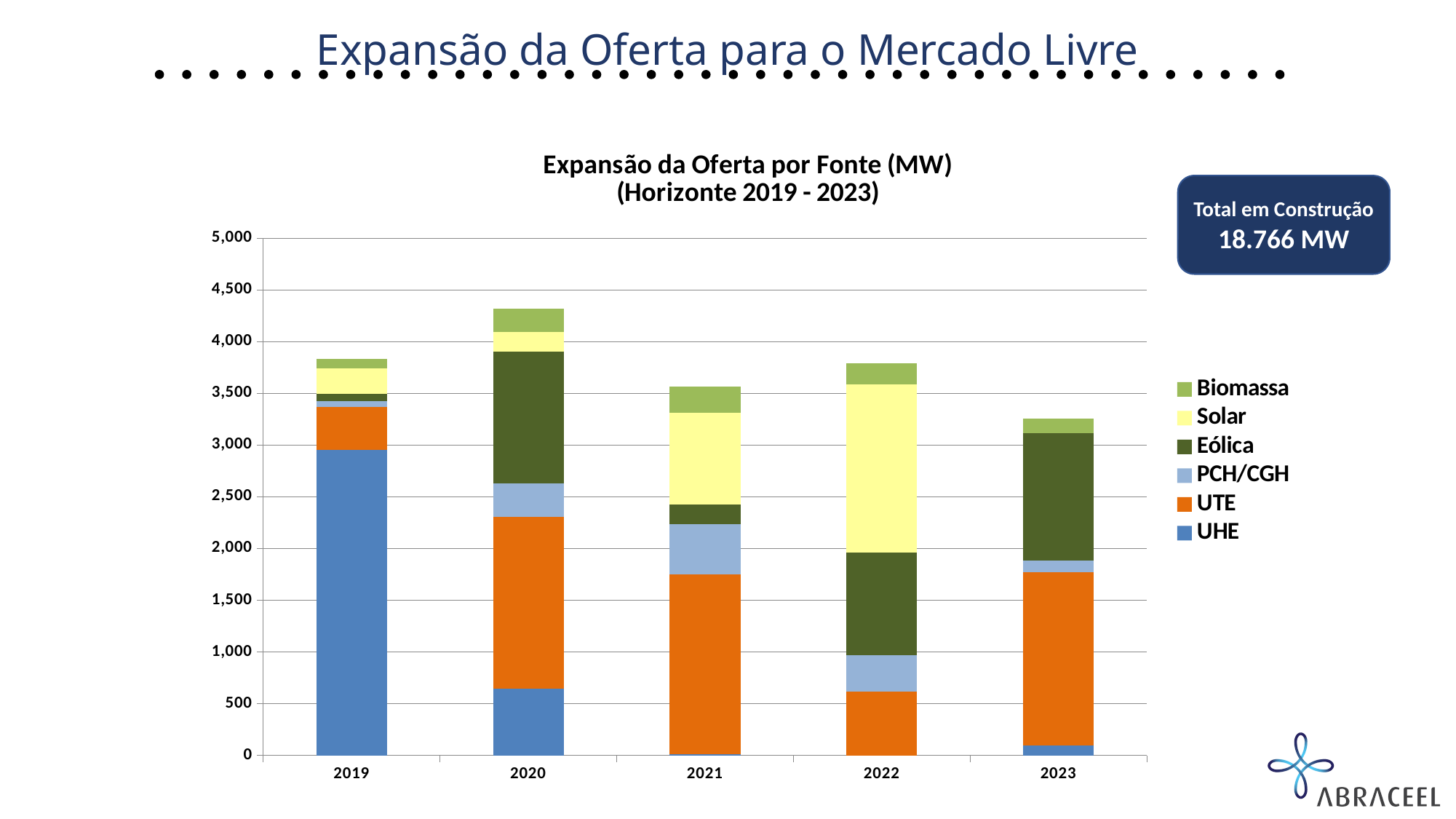
Is the UHE segment for 2019 greater or less than 2,500? greater Which year has the highest total stacked bar? 2020 Is the total stacked bar for 2023 greater or less than 3,500? less Which total stacked bar is taller, 2019 or 2021? 2019 How many years are shown on the x axis? 5 What is the title of the chart? Expansão da Oferta por Fonte (MW) (Horizonte 2019 - 2023) Which source has the largest segment in the 2022 bar? Solar Which year has the lowest total stacked bar? 2023 What total under construction is shown in the box next to the chart? 18.766 MW How many series does the legend list? 6 What kind of chart is shown on the slide? Stacked bar chart Is the total stacked bar for 2020 greater or less than 4,000? greater